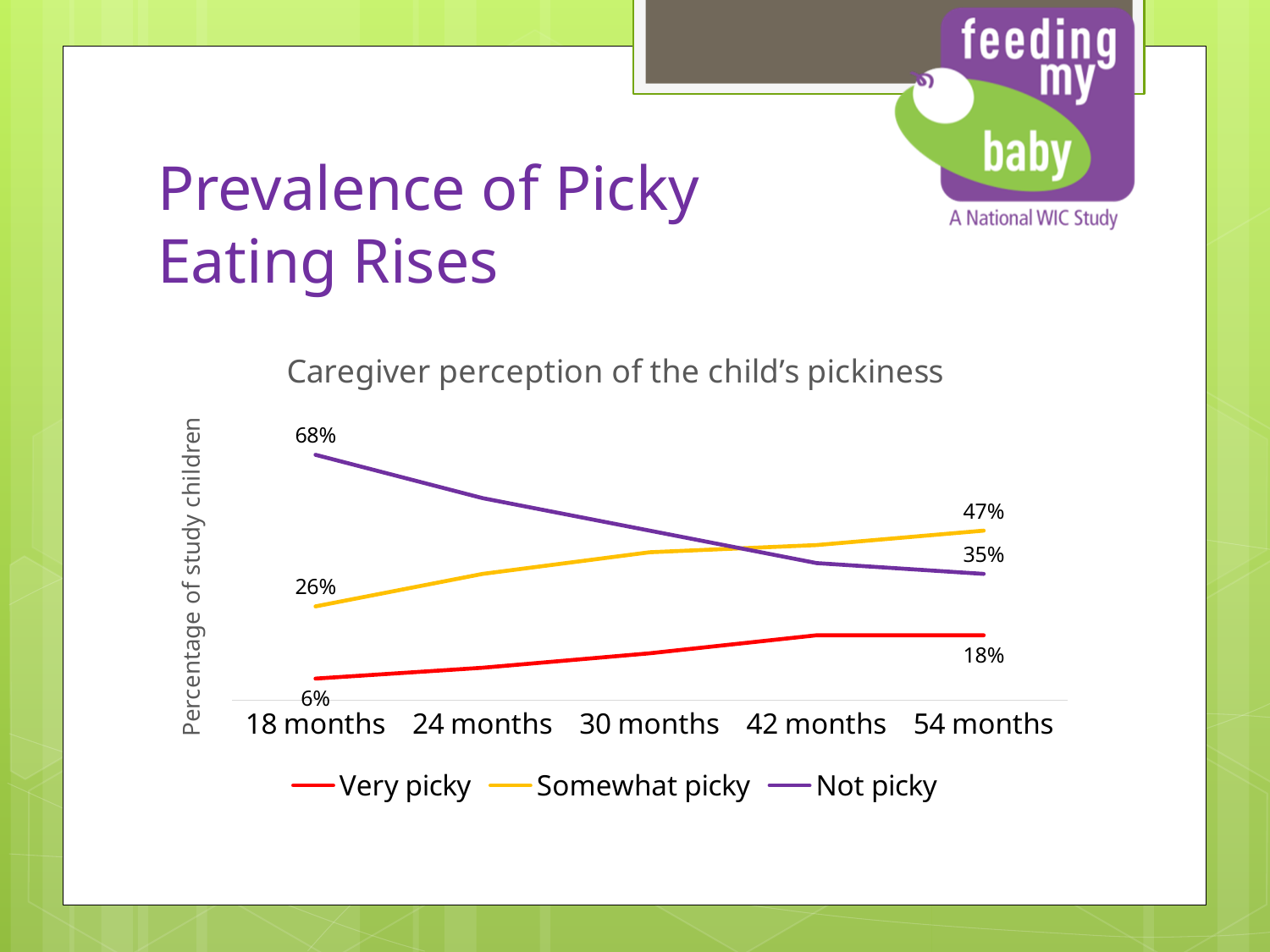
Which series has the lowest value at 18 months? Very picky What is the value for Not picky at 18 months? 68% By how many percentage points does the Not picky value fall from 18 months to 54 months? 33 percentage points What is the title of the chart? Caregiver perception of the child's pickiness How many series does the legend list? 3 How many age points are shown on the x axis? 5 What is the value for Not picky at 54 months? 35% What is the value for Somewhat picky at 54 months? 47% What is the value for Very picky at 18 months? 6% Does the Very picky series rise or fall from 18 months to 54 months? Rise Which series has the highest value at 54 months? Somewhat picky What kind of chart is shown on the slide? Line chart